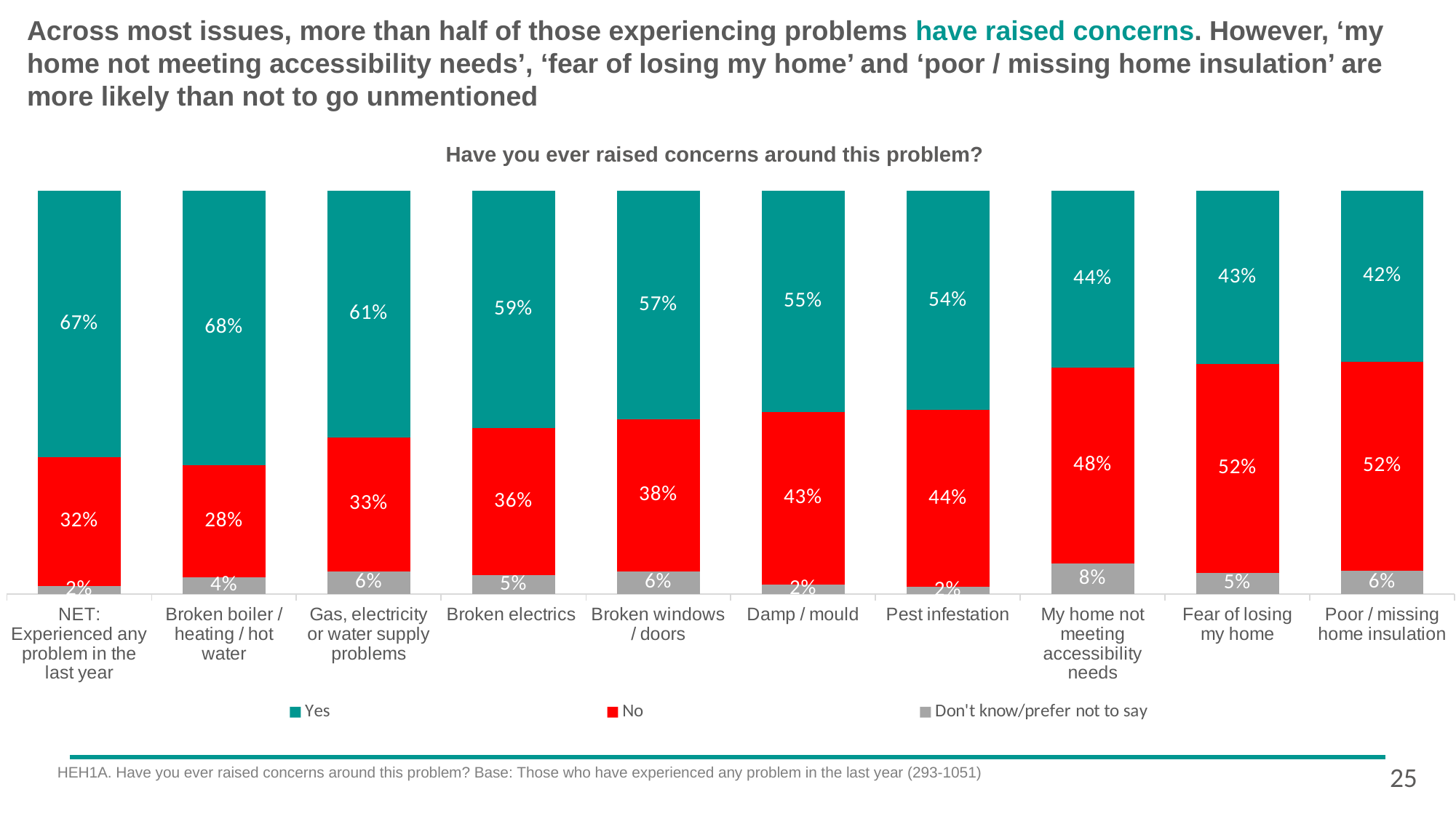
Which is larger for 'Fear of losing my home': the 'Yes' share or the 'No' share? No How many series does the legend list? 3 Which category has the highest 'Don't know/prefer not to say' percentage? My home not meeting accessibility needs What kind of chart is shown on the slide? Stacked bar chart What is the 'No' value for 'My home not meeting accessibility needs'? 48% What is the title of the chart? Have you ever raised concerns around this problem? What is the 'Don't know/prefer not to say' value for 'Broken boiler / heating / hot water'? 4% How many problem categories are shown on the x axis? 10 Which category has the highest 'Yes' percentage? Broken boiler / heating / hot water What is the difference between the 'Yes' and 'No' percentages for 'Pest infestation'? 10 percentage points What percentage of those experiencing 'Damp / mould' answered 'Yes' to having raised concerns? 55% Which category has the lowest 'Yes' percentage? Poor / missing home insulation